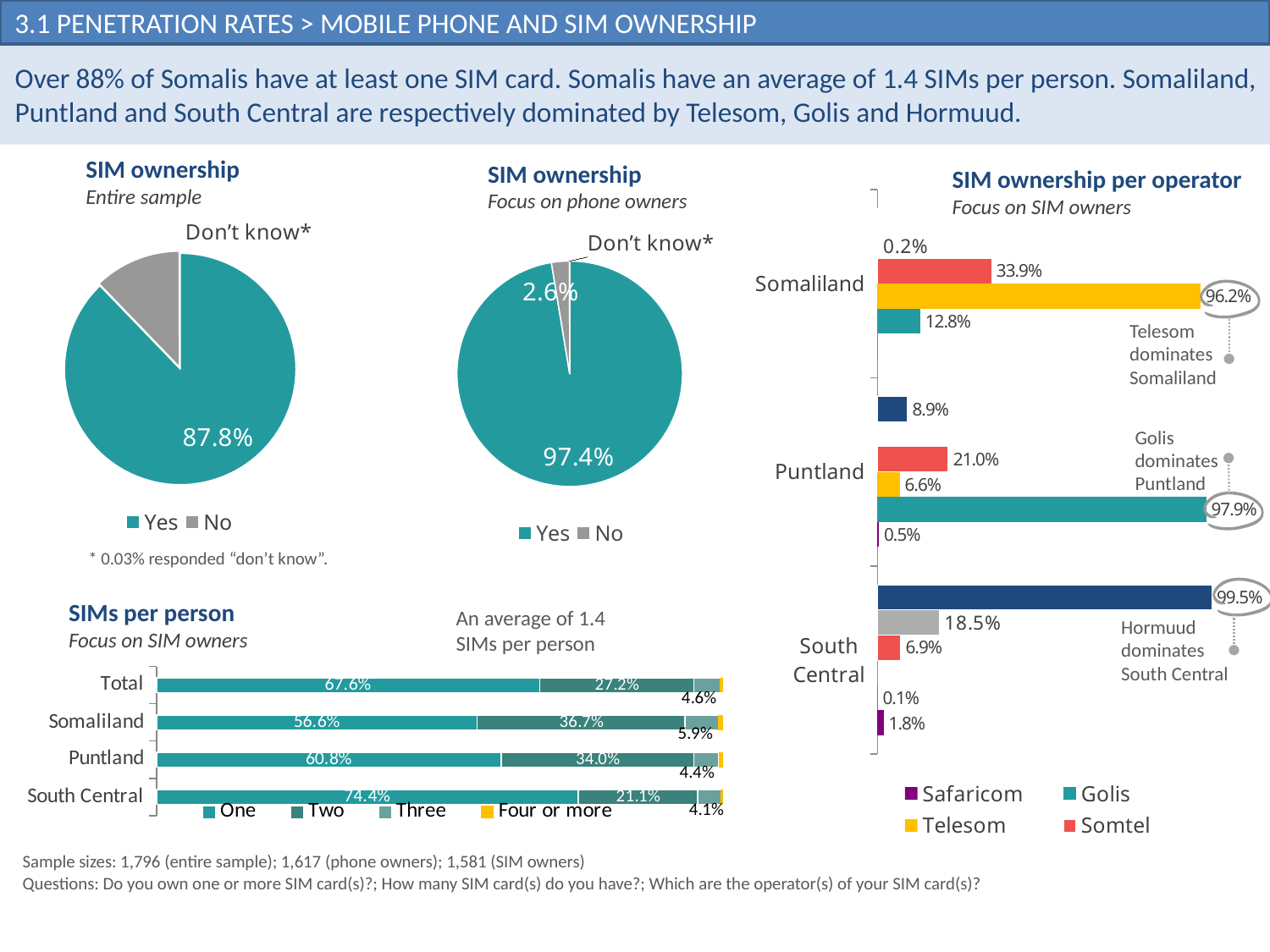
How many series does the legend of the 'SIMs per person' chart list? 4 In the 'SIM ownership per operator' chart, what is the value for Telesom in Somaliland? 96.2% What kind of chart is the 'SIM ownership – Entire sample' chart? Pie chart In the 'SIM ownership – Entire sample' pie chart, what share of respondents answered Yes? 87.8% In the 'SIM ownership per operator' chart, what is the difference between the Somtel value in Somaliland (33.9%) and in Puntland (21.0%)? 12.9 percentage points In the 'SIMs per person' chart, what share of SIM owners in Somaliland have two SIMs? 36.7% In the 'SIMs per person' chart, what share of SIM owners in South Central have one SIM? 74.4% In the 'SIM ownership per operator' chart, what is the value for Golis in Puntland? 97.9% In the 'SIMs per person' chart, which region has the highest share of SIM owners with one SIM? South Central In the 'SIM ownership – Focus on phone owners' pie chart, what share of respondents answered No? 2.6% In the 'SIM ownership per operator' chart, what is the value for Somtel in Somaliland? 33.9% In the 'SIMs per person' chart, is the share with two SIMs larger in Somaliland or in Puntland? Somaliland